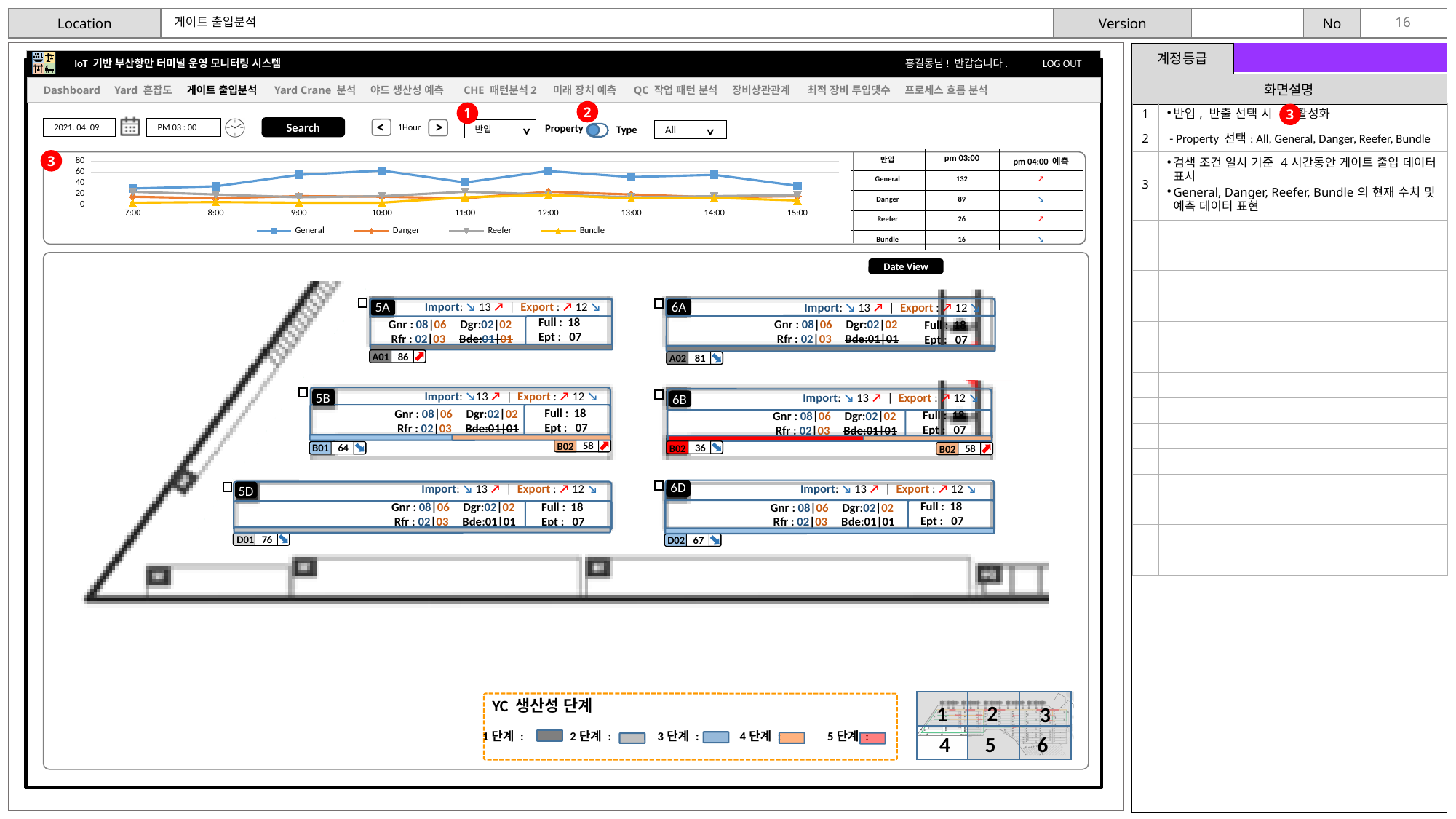
Does the General series rise or fall from 7:00 to 10:00? rise What kind of chart is shown at the top of the dashboard? line chart How many time points are plotted along the x axis of the line chart? 9 Is the value for Danger at 9:00 greater or less than 40? less Is the value for General at 10:00 greater or less than 40? greater What are the four legend entries of the line chart, in order? General, Danger, Reefer, Bundle Which series has the highest value at 10:00 in the line chart? General Which is larger in the line chart: General at 12:00 or Reefer at 12:00? General at 12:00 Does the General series rise or fall from 14:00 to 15:00? fall How many series does the legend of the line chart list? 4 Is the value for Bundle at 7:00 greater or less than 20? less Which series has the lowest value at 7:00 in the line chart? Bundle